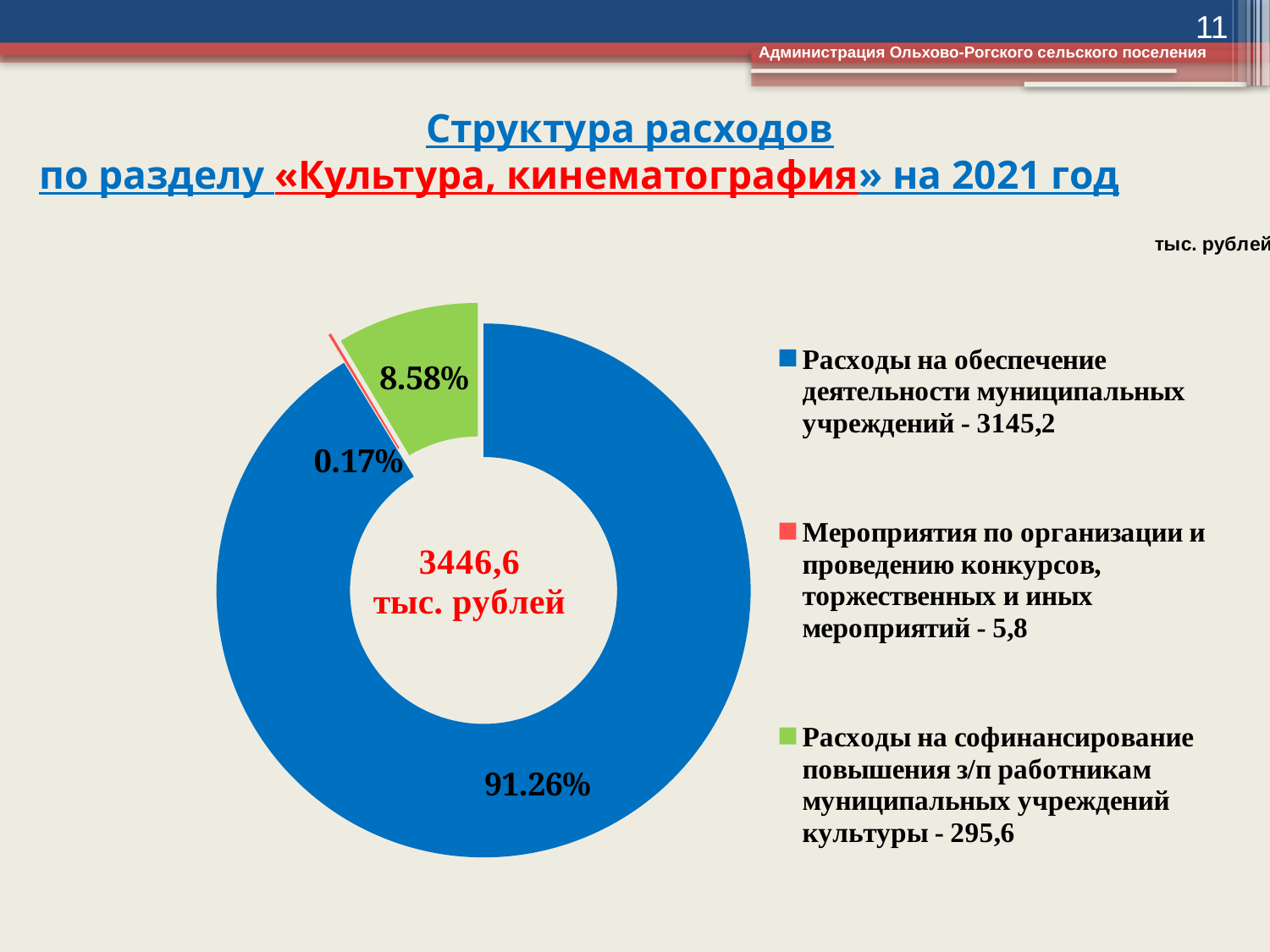
What colour is the slice for "Расходы на софинансирование повышения з/п работникам муниципальных учреждений культуры"? Green How many categories does the legend list? 3 What value (тыс. рублей) is given in the legend for "Расходы на обеспечение деятельности муниципальных учреждений"? 3145,2 What value (тыс. рублей) is given in the legend for "Расходы на софинансирование повышения з/п работникам муниципальных учреждений культуры"? 295,6 What share of the chart does "Расходы на софинансирование повышения з/п работникам муниципальных учреждений культуры" take? 8.58% What share of the chart does "Мероприятия по организации и проведению конкурсов, торжественных и иных мероприятий" take? 0.17% What share of the chart does "Расходы на обеспечение деятельности муниципальных учреждений" take? 91.26% Which category has the smallest share of the chart? Мероприятия по организации и проведению конкурсов, торжественных и иных мероприятий What total amount is shown in the centre of the chart? 3446,6 тыс. рублей Which category has the largest share of the chart? Расходы на обеспечение деятельности муниципальных учреждений What value (тыс. рублей) is given in the legend for "Мероприятия по организации и проведению конкурсов, торжественных и иных мероприятий"? 5,8 What kind of chart is shown on the slide? Doughnut (pie) chart